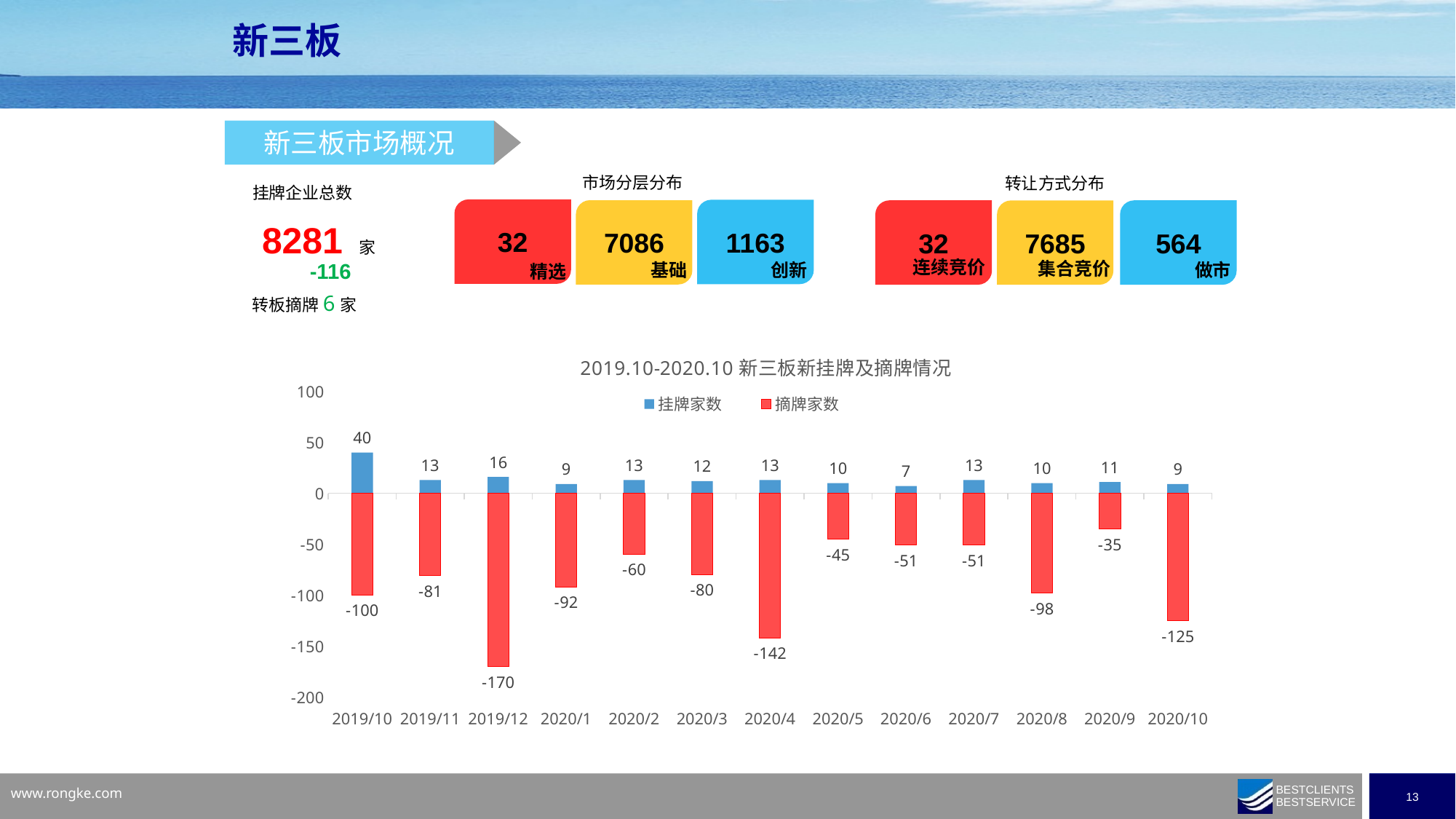
Which month has the highest 挂牌家数 value? 2019/10 How many months (categories) are shown on the x axis of the chart? 13 What type of chart is shown on the slide? bar chart What is the value of 挂牌家数 for 2019/10? 40 What is the title of the chart? 2019.10-2020.10 新三板新挂牌及摘牌情况 Which month has the lowest 挂牌家数 value? 2020/6 What is the difference between the 挂牌家数 values for 2019/10 and 2019/11? 27 Which is larger in magnitude, the 摘牌家数 for 2020/8 or for 2020/10? 2020/10 How many series does the chart legend list? 2 What is the value of 摘牌家数 for 2020/9? -35 Which month has the lowest 摘牌家数 value (the largest number of delistings)? 2019/12 What is the value of 摘牌家数 for 2020/4? -142